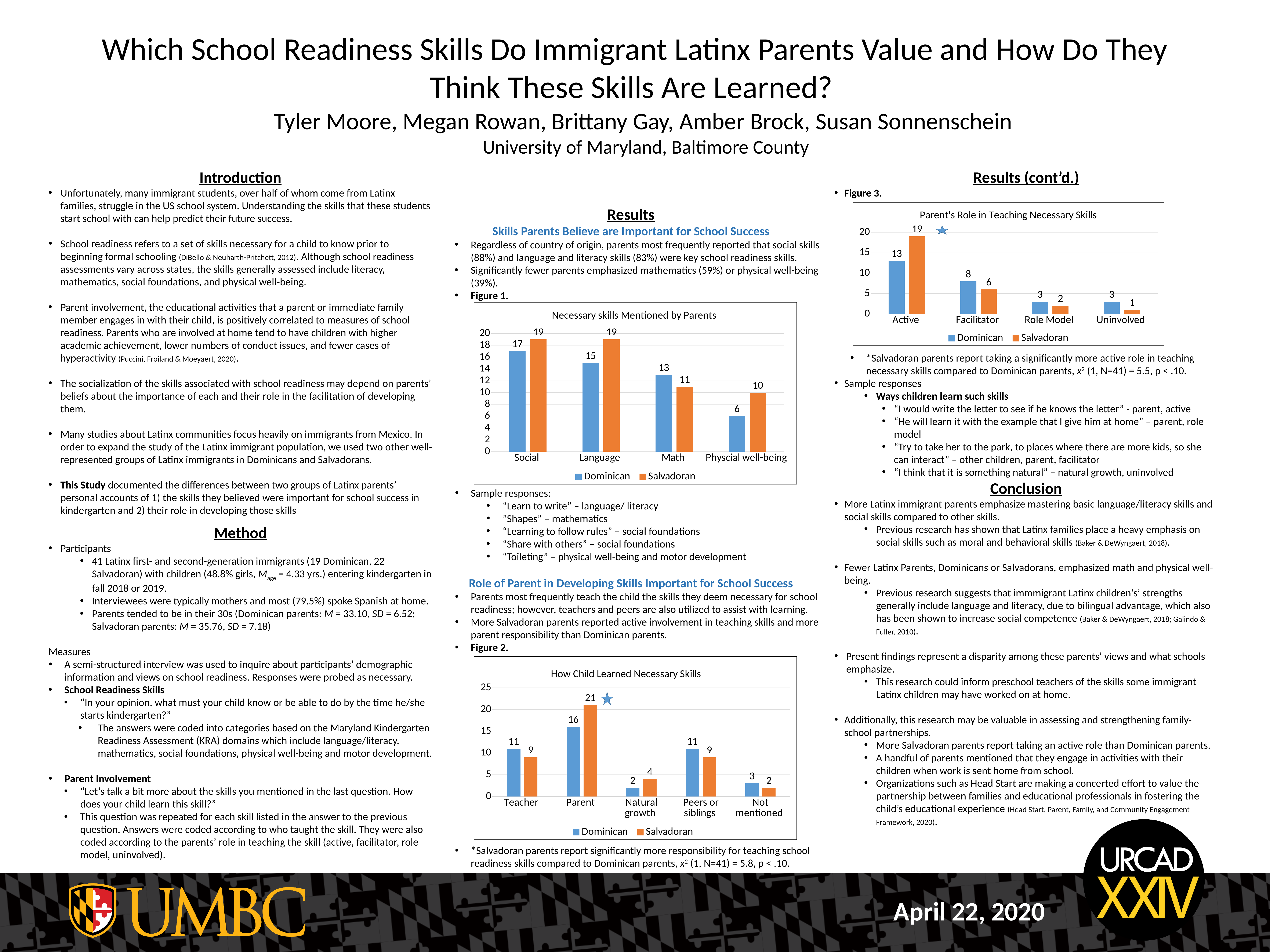
In the 'Necessary skills Mentioned by Parents' chart, what is the difference between the Salvadoran and Dominican values for Physcial well-being? 4 In the 'How Child Learned Necessary Skills' chart, is the Dominican value for Teacher larger or the Salvadoran value for Teacher? Dominican What type of chart is 'Parent's Role in Teaching Necessary Skills'? Bar chart In the 'Parent's Role in Teaching Necessary Skills' chart, what is the difference between the Dominican and Salvadoran values for Facilitator? 2 In the 'Necessary skills Mentioned by Parents' chart, what is the Dominican value for Math? 13 In the 'Parent's Role in Teaching Necessary Skills' chart, what is the Salvadoran value for Active? 19 In the 'Necessary skills Mentioned by Parents' chart, what is the Salvadoran value for Language? 19 In the 'Necessary skills Mentioned by Parents' chart, which category has the lowest Dominican value? Physcial well-being In the 'Parent's Role in Teaching Necessary Skills' chart, how many series does the legend list? 2 In the 'How Child Learned Necessary Skills' chart, which category has the highest Dominican value? Parent In the 'How Child Learned Necessary Skills' chart, how many categories are shown on the x axis? 5 In the 'How Child Learned Necessary Skills' chart, what is the Salvadoran value for Parent? 21